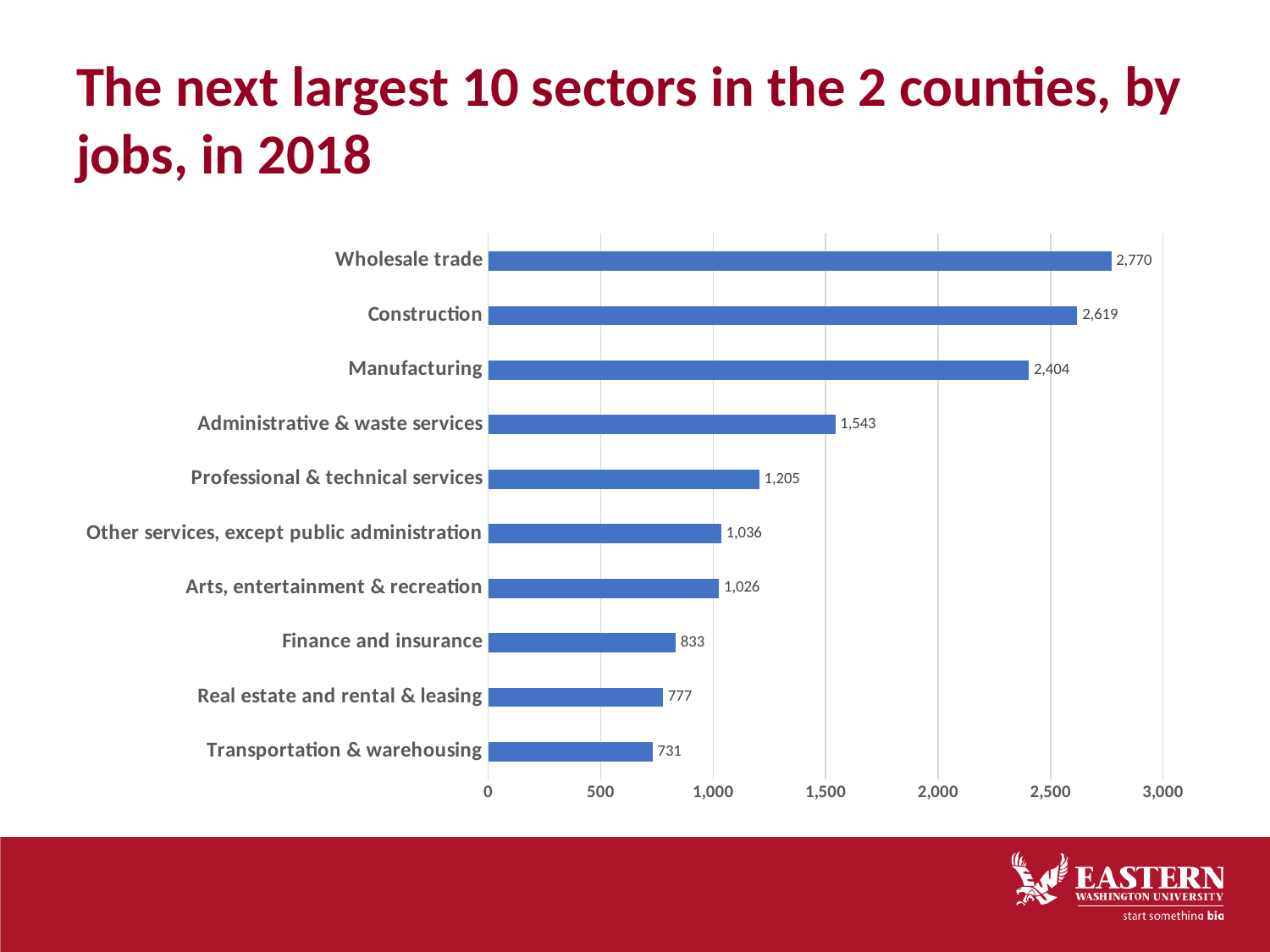
Is the value for Manufacturing greater or less than 2,500? less How many jobs does the Wholesale trade sector have? 2,770 Which has more jobs, Real estate and rental & leasing or Transportation & warehousing? Real estate and rental & leasing What is the maximum value shown on the horizontal axis? 3,000 How many sectors are shown in the chart? 10 Which sector has the lowest number of jobs? Transportation & warehousing What is the value shown for Manufacturing? 2,404 What kind of chart is shown on the slide? Bar chart What is the difference in jobs between Wholesale trade and Construction? 151 What is the difference in jobs between Administrative & waste services and Professional & technical services? 338 Which sector has the highest number of jobs? Wholesale trade What is the value shown for Finance and insurance? 833